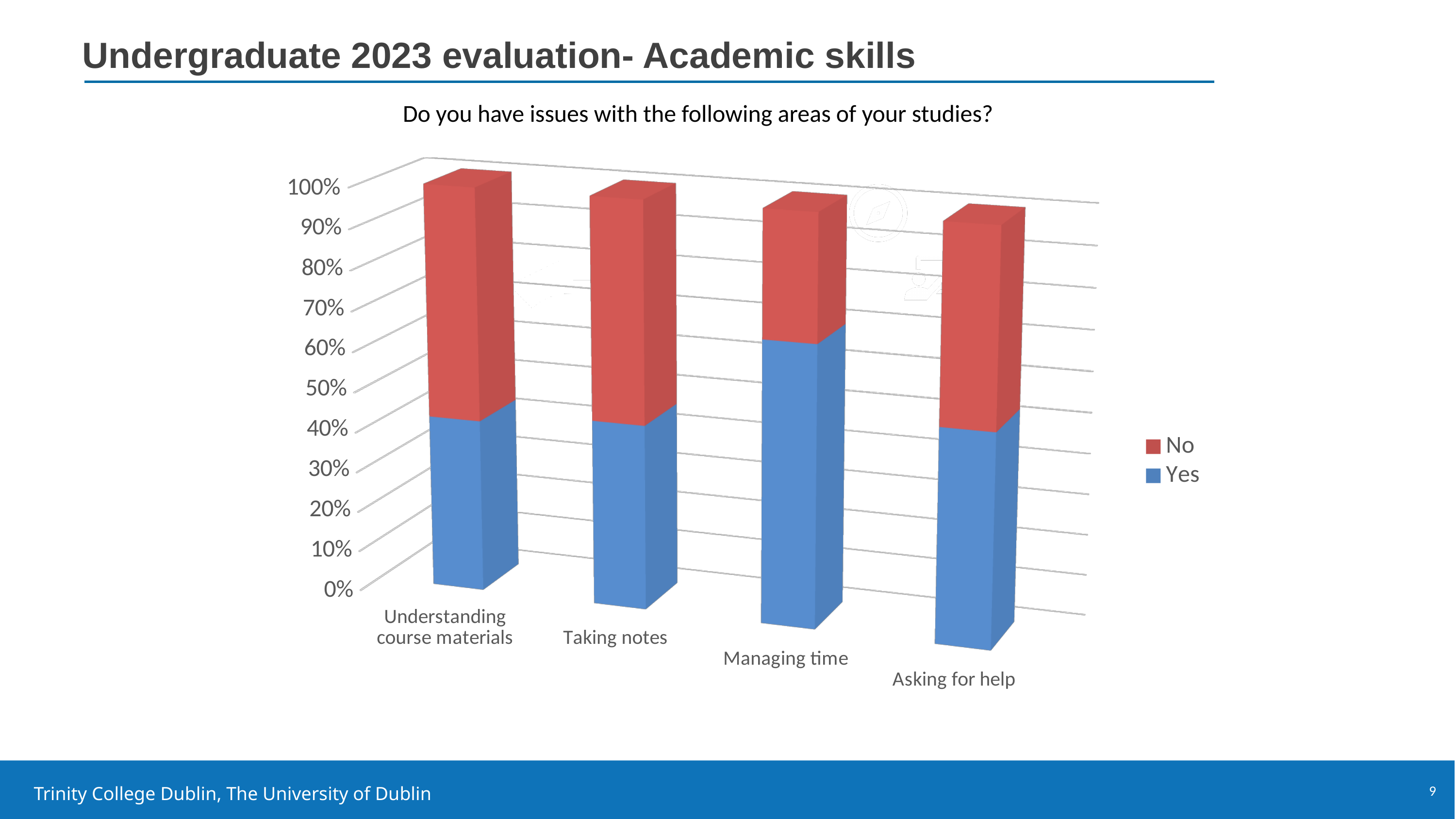
What is the title of the chart? Do you have issues with the following areas of your studies? How many categories are shown on the x axis of the chart? 4 What kind of chart is shown on the slide? Stacked bar chart How many series does the chart's legend list? 2 Which colour represents the "Yes" series in the chart? Blue Which category has the largest "Yes" share? Managing time Is the "Yes" value for Understanding course materials greater or less than 50%? less Which has the larger "Yes" share: Managing time or Taking notes? Managing time Is the "Yes" value for Managing time greater or less than 50%? greater Which category has the smallest "No" share? Managing time Is the "Yes" value for Taking notes greater or less than 60%? less